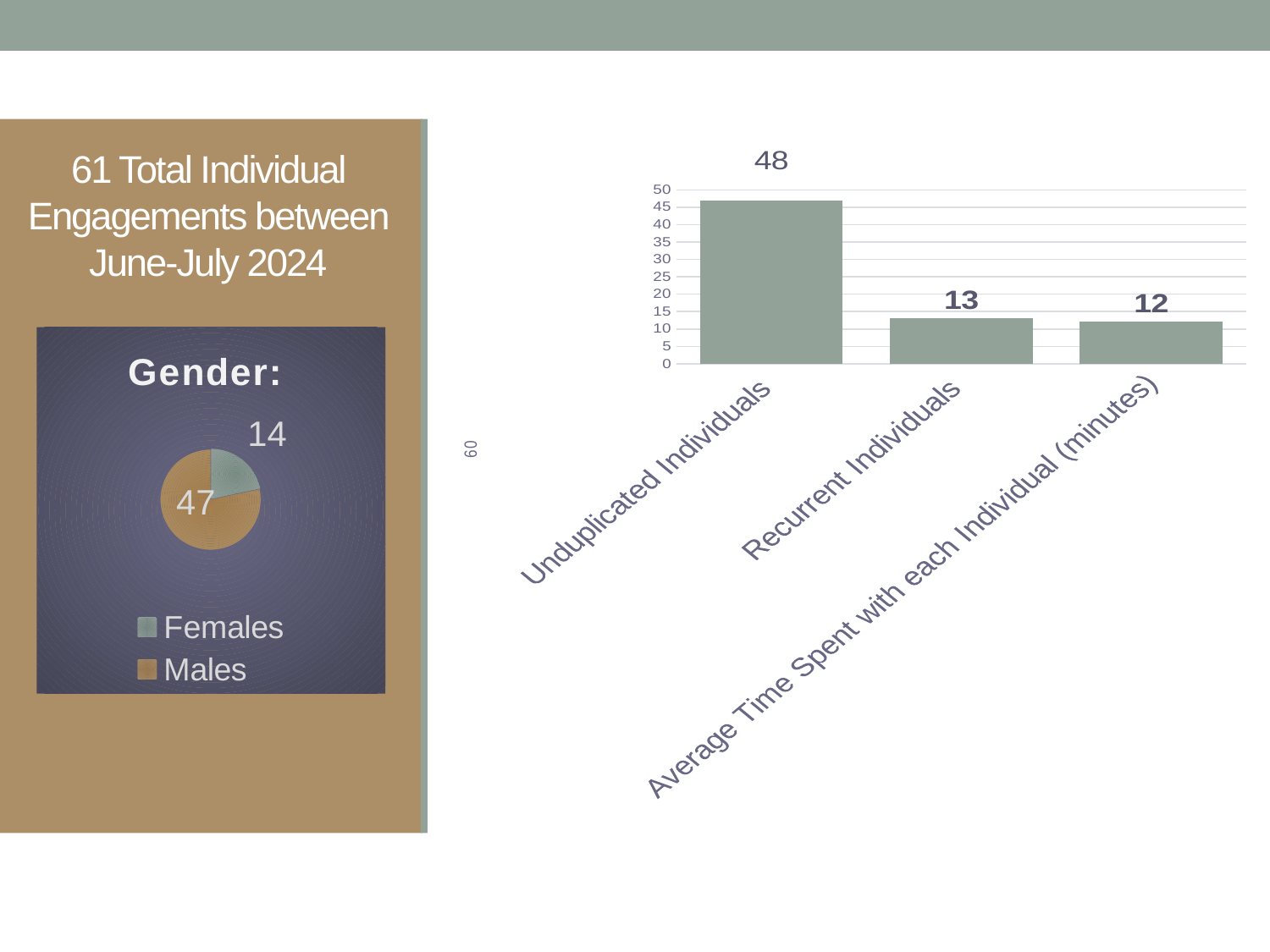
How many bars are in the bar chart on the right? 3 In the Gender pie chart, what is the value for Females? 14 In the Gender pie chart, what is the difference between the Males and Females values? 33 In the Gender pie chart, how many categories does the legend list? 2 In the bar chart on the right, which category has the highest value? Unduplicated Individuals What kind of chart is the Gender chart on the left of the slide? Pie chart In the bar chart on the right, what is the value for Recurrent Individuals? 13 In the bar chart on the right, what is the difference between Unduplicated Individuals and Recurrent Individuals? 35 In the Gender pie chart, what is the value for Males? 47 In the bar chart on the right, what is the value for Unduplicated Individuals? 48 In the bar chart on the right, what is the value for Average Time Spent with each Individual (minutes)? 12 In the Gender pie chart, which category has the larger slice? Males